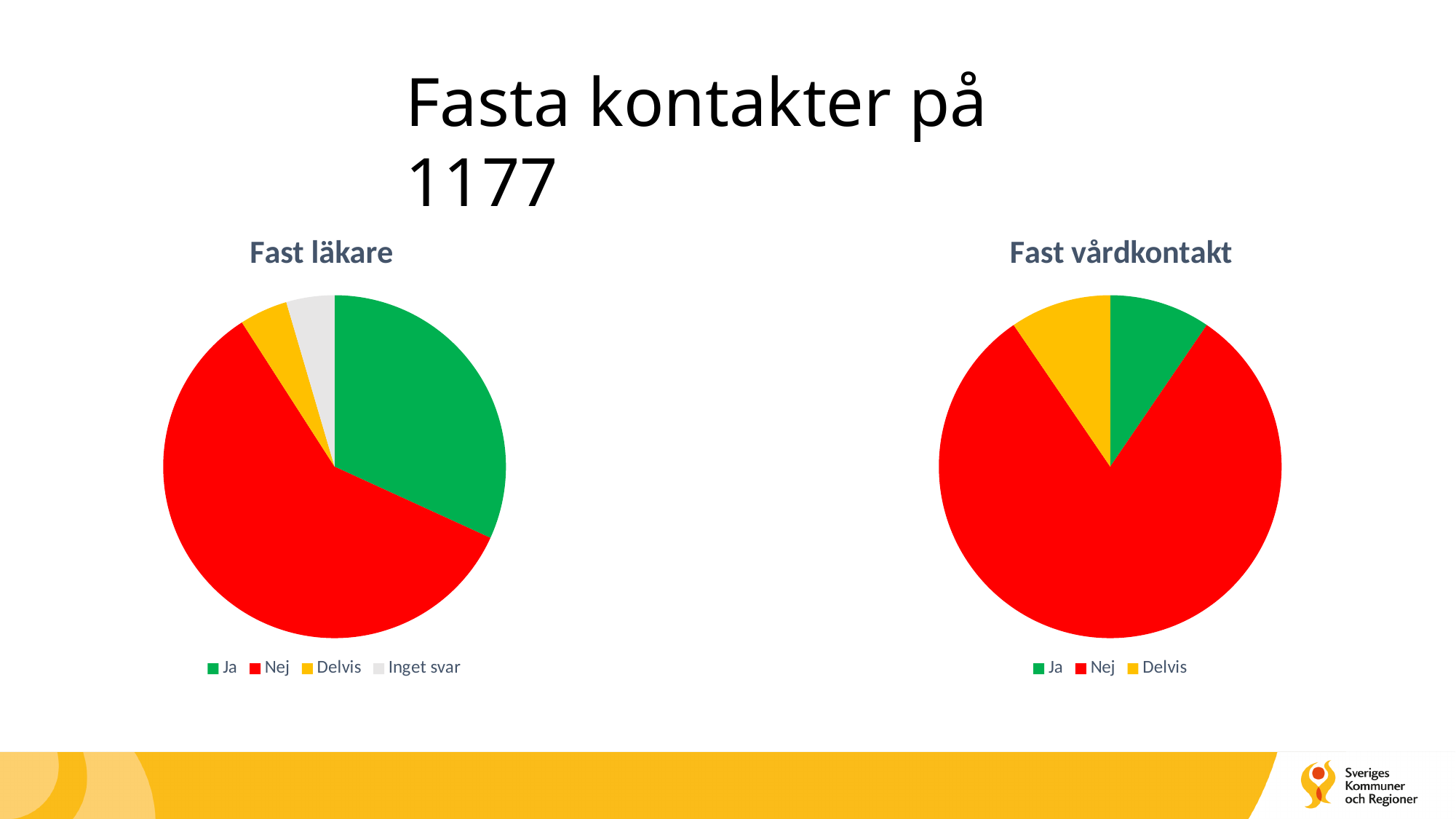
Which legend entry appears in the "Fast läkare" chart but not in the "Fast vårdkontakt" chart? Inget svar What kind of chart is the "Fast vårdkontakt" chart? pie chart In the "Fast läkare" chart, which category has the largest slice? Nej In the "Fast vårdkontakt" chart, which category has the largest slice? Nej What kind of chart is the "Fast läkare" chart? pie chart How many slices does the "Fast vårdkontakt" pie chart have? 3 How many slices does the "Fast läkare" pie chart have? 4 In the "Fast läkare" chart, which slice is larger, Ja or Delvis? Ja In the "Fast läkare" chart, which slice is larger, Ja or Nej? Nej What colour is the "Nej" slice in the "Fast vårdkontakt" chart? red